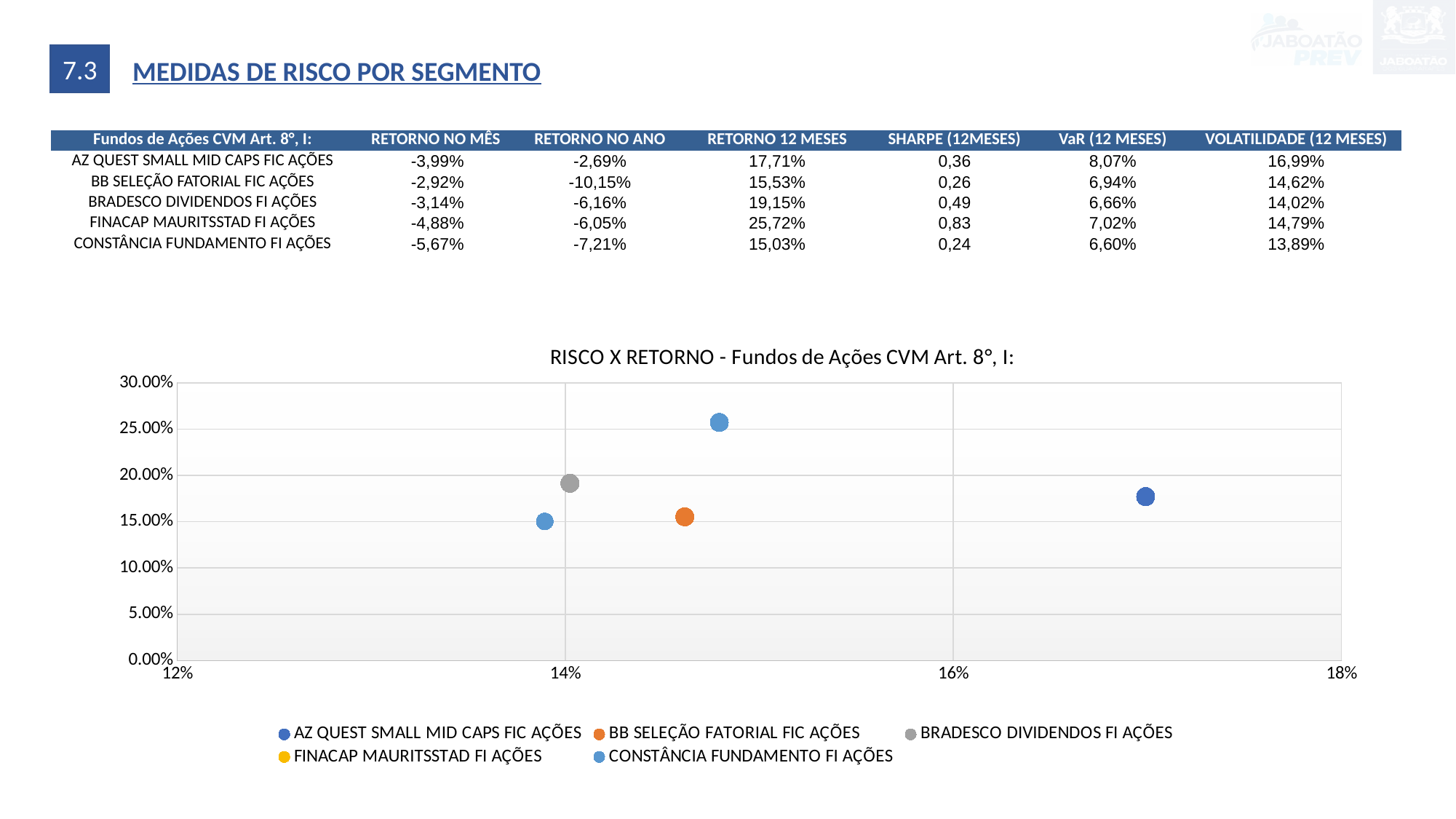
In the RISCO X RETORNO chart, is the y-axis value of the highest plotted point greater or less than 25.00%? greater What is the highest tick label shown on the y-axis of the RISCO X RETORNO chart? 30.00% In the RISCO X RETORNO chart, which has a higher y-axis value: BRADESCO DIVIDENDOS FI AÇÕES or BB SELEÇÃO FATORIAL FIC AÇÕES? BRADESCO DIVIDENDOS FI AÇÕES In the RISCO X RETORNO chart, is the y-axis value for BB SELEÇÃO FATORIAL FIC AÇÕES greater or less than 20.00%? less How many series does the legend of the RISCO X RETORNO chart list? 5 In the RISCO X RETORNO chart, is the x-axis value for BB SELEÇÃO FATORIAL FIC AÇÕES greater or less than 14%? greater How many data points are plotted in the RISCO X RETORNO chart? 5 What kind of chart is shown under the title "RISCO X RETORNO - Fundos de Ações CVM Art. 8°, I:"? Scatter chart In the RISCO X RETORNO chart, which series has the point furthest to the right (highest volatility)? AZ QUEST SMALL MID CAPS FIC AÇÕES